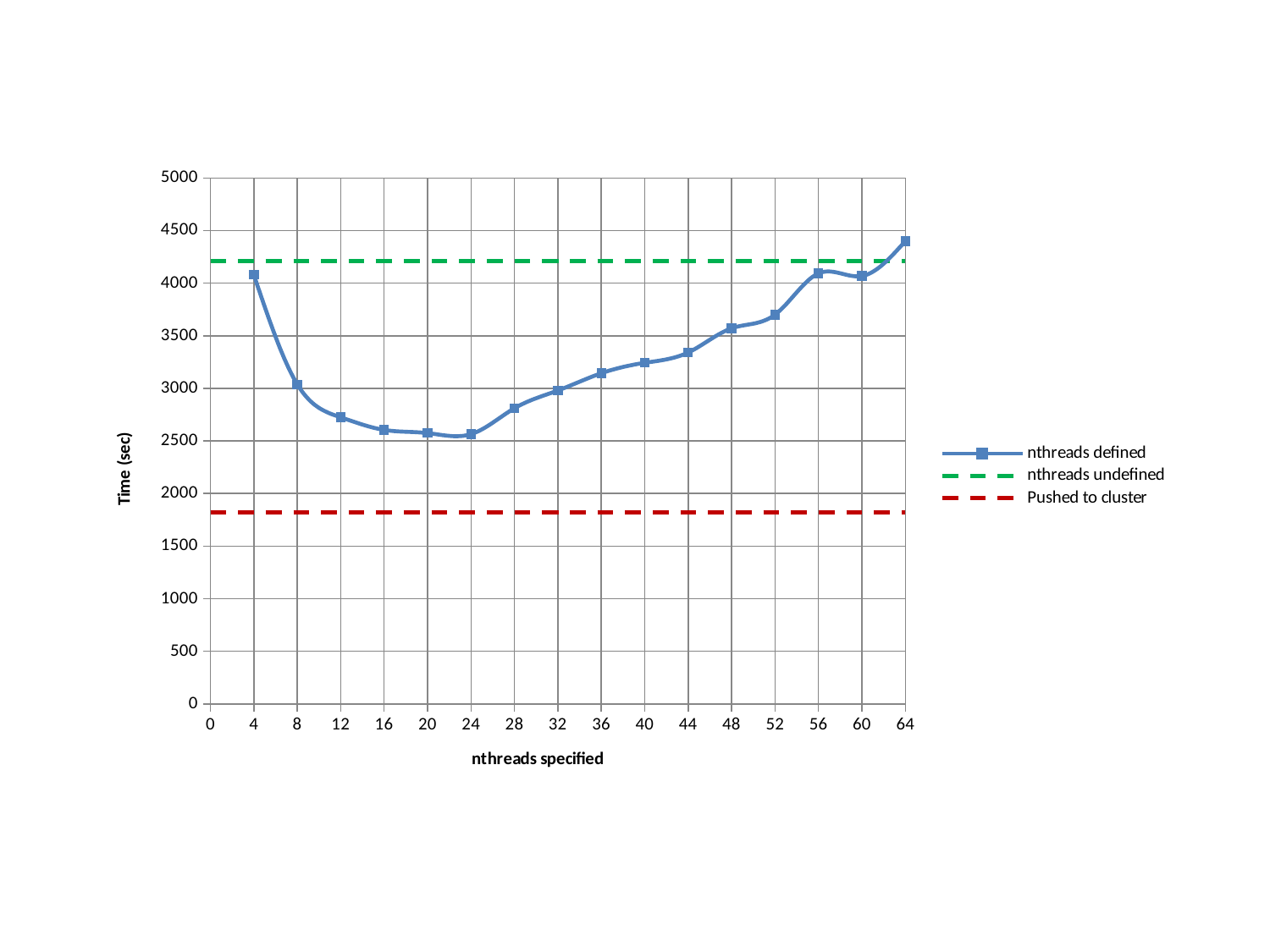
Which has the larger 'nthreads defined' time: 4 threads or 8 threads? 4 threads Is the 'nthreads undefined' line greater or less than 4000? greater At which value of nthreads specified is the 'nthreads defined' time highest? 64 Is the 'Pushed to cluster' line greater or less than 2000? less Is the 'nthreads defined' value at 24 threads greater or less than 3000? less How many series does the legend list? 3 What kind of chart is shown on the slide? line chart Does the 'nthreads defined' series rise or fall between 24 and 64 threads? rise What is the title of the y axis? Time (sec) How many data points are plotted for the 'nthreads defined' series? 16